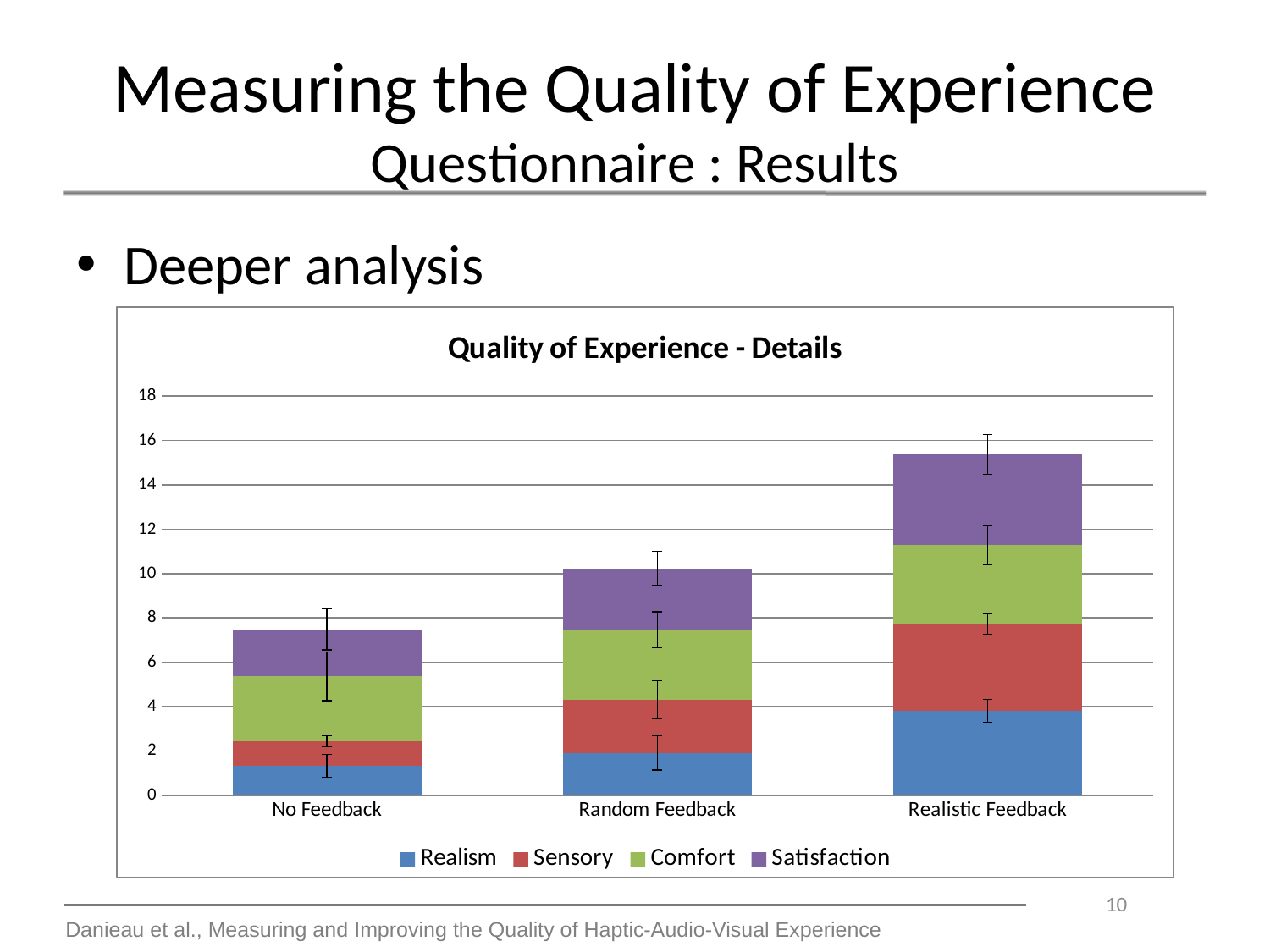
Is the total stacked value for No Feedback greater or less than 8? less Which category has the lowest total stacked bar? No Feedback Is the total stacked value for Random Feedback greater or less than 12? less Do the total stacked values rise or fall from No Feedback to Realistic Feedback along the x axis? rise Is the total stacked value for Realistic Feedback greater or less than 14? greater What is the title of the chart? Quality of Experience - Details How many series does the legend list? 4 Which series is shown in blue at the bottom of each stacked bar? Realism What kind of chart is shown on the slide? stacked bar chart How many categories are shown on the x axis? 3 Which category has the highest total stacked bar? Realistic Feedback Which has a larger total stacked bar, Random Feedback or Realistic Feedback? Realistic Feedback